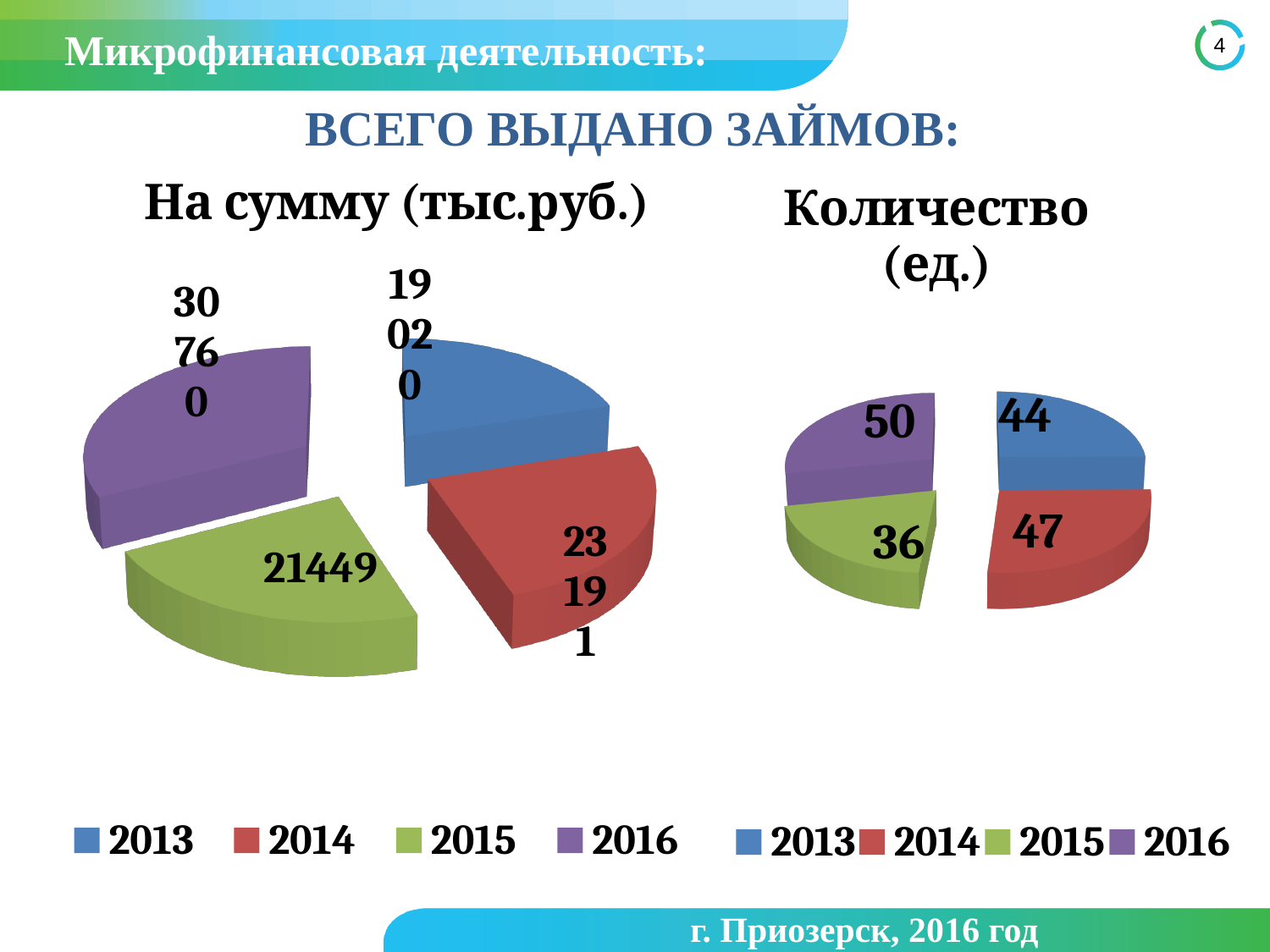
In the "Количество (ед.)" chart, what is the value for 2015? 36 In the "Количество (ед.)" chart, what is the value for 2014? 47 In the "На сумму (тыс.руб.)" chart, what is the value for 2016? 30760 In the "На сумму (тыс.руб.)" chart, which is larger, the value for 2014 or the value for 2015? 2014 In the "Количество (ед.)" chart, what is the difference between the values for 2016 and 2015? 14 In the "На сумму (тыс.руб.)" chart, which year has the lowest value? 2013 In the "На сумму (тыс.руб.)" chart, what is the value for 2015? 21449 In the "Количество (ед.)" chart, which year has the highest value? 2016 What kind of chart is the "На сумму (тыс.руб.)" chart? pie chart How many slices does the "Количество (ед.)" pie chart have? 4 In the "Количество (ед.)" chart, which year has the lowest value? 2015 What is the total of all slices in the "Количество (ед.)" chart? 177